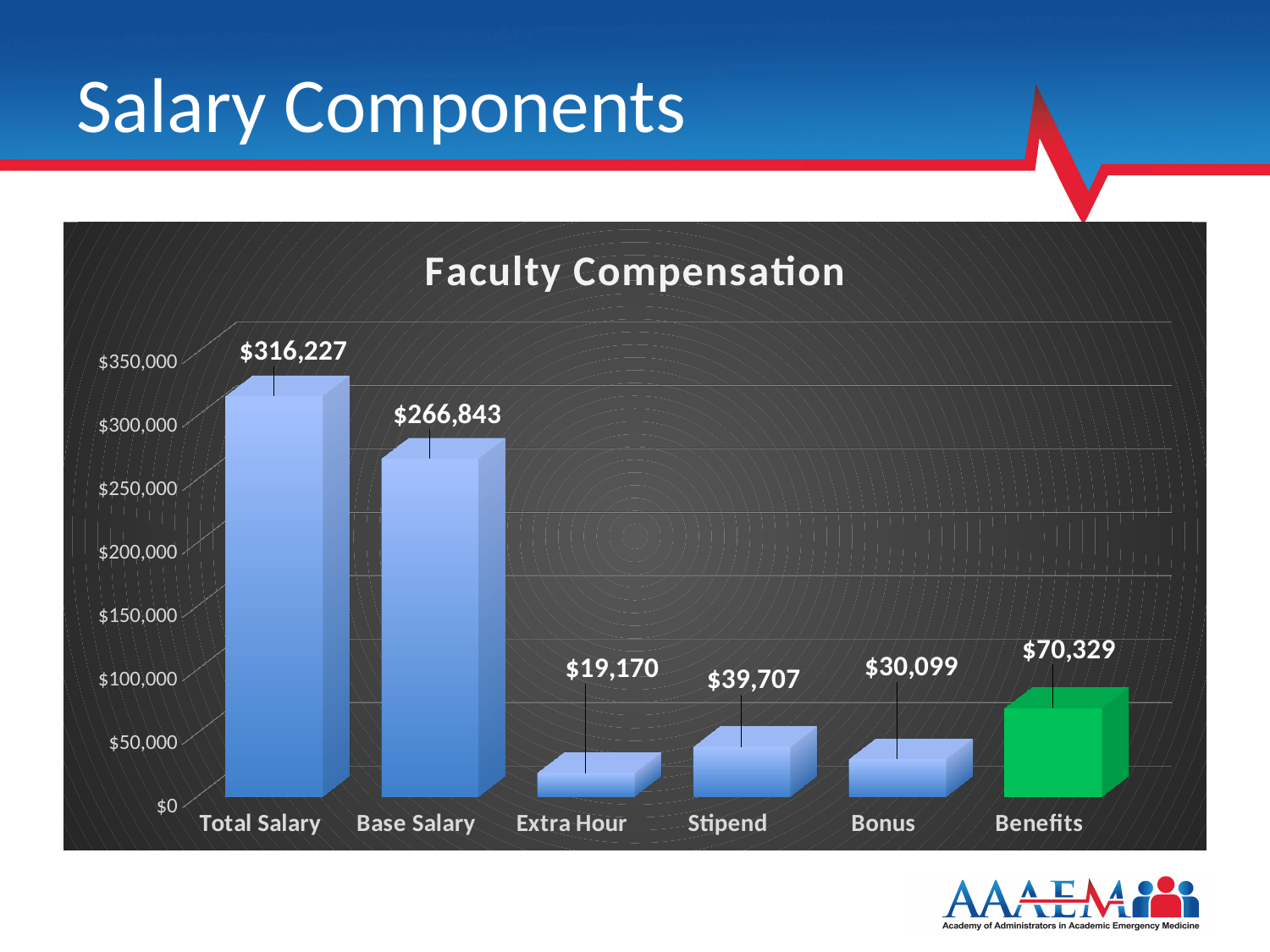
How many categories are shown in the chart? 6 What is the value for Base Salary? $266,843 Which is larger, Stipend or Bonus? Stipend What is the title of the chart? Faculty Compensation What is the value for Total Salary? $316,227 What kind of chart is shown? bar chart What is the value for Extra Hour? $19,170 What is the value for Benefits? $70,329 Is the value for Benefits greater or less than $100,000? less Which category has the highest value? Total Salary What is the difference between Total Salary and Base Salary? $49,384 Which category has the lowest value? Extra Hour